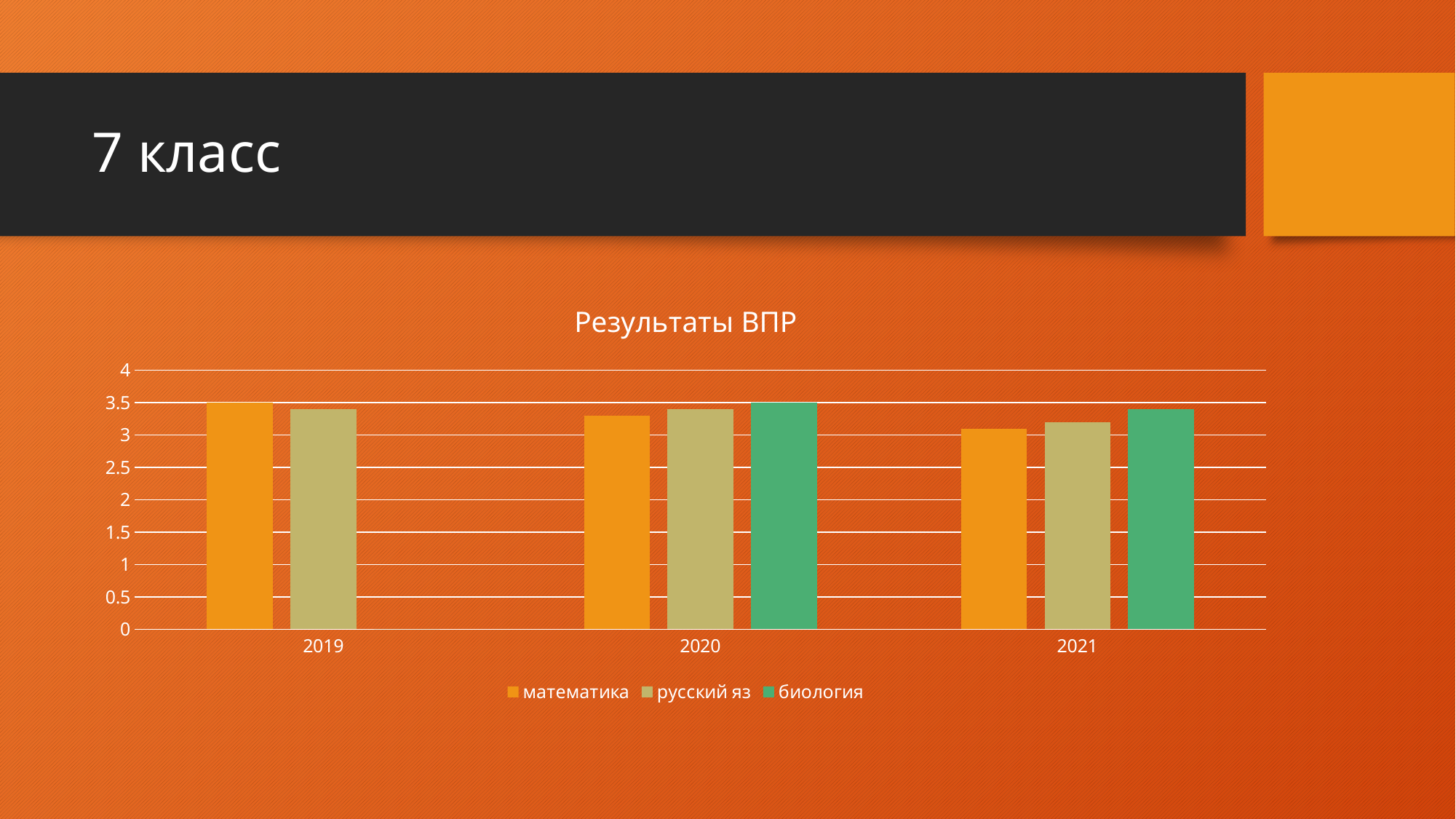
In 2021, which subject has the highest value? биология How many year categories are shown on the x axis? 3 How many series does the legend list? 3 What kind of chart is shown on the slide? bar chart Is the value for биология in 2021 greater or less than 3? greater Is the value for математика in 2021 greater or less than 3.5? less Which series is shown in green? биология Which is larger: математика in 2019 or математика in 2021? математика in 2019 How many bars are plotted for 2019? 2 What is the title of the chart? Результаты ВПР Does the value for математика rise or fall from 2019 to 2021? fall Is the value for математика in 2019 greater or less than 3? greater